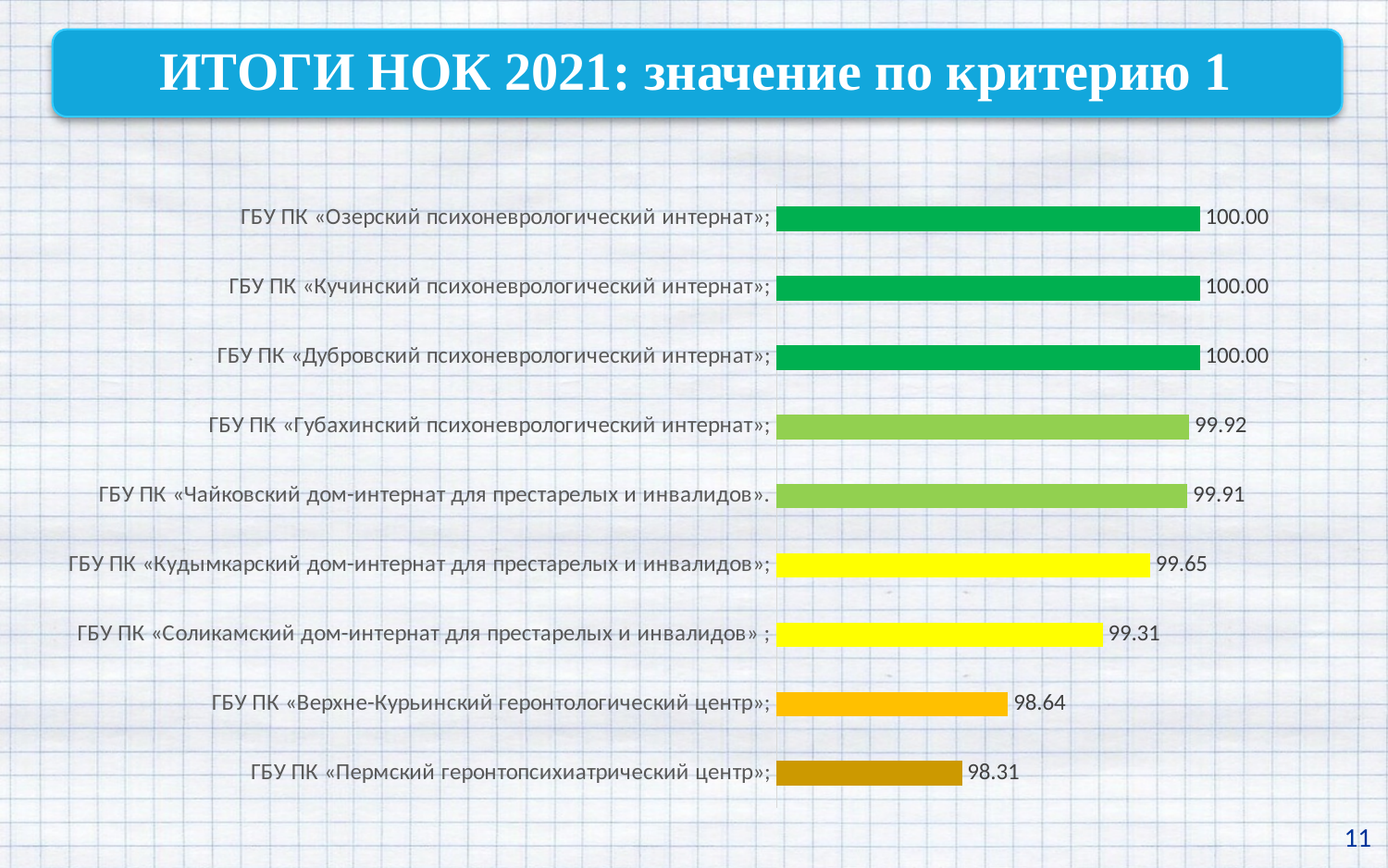
Which is larger: the value for ГБУ ПК «Чайковский дом-интернат для престарелых и инвалидов» or the value for ГБУ ПК «Соликамский дом-интернат для престарелых и инвалидов»? ГБУ ПК «Чайковский дом-интернат для престарелых и инвалидов» How many categories are shown on the chart? 9 What is the difference between the values for ГБУ ПК «Соликамский дом-интернат для престарелых и инвалидов» and ГБУ ПК «Пермский геронтопсихиатрический центр»? 1.00 What is the highest value shown on the chart? 100.00 What kind of chart is shown on the slide? Bar chart What is the title of the slide containing the chart? ИТОГИ НОК 2021: значение по критерию 1 What is the value for ГБУ ПК «Верхне-Курьинский геронтологический центр»? 98.64 What is the value for ГБУ ПК «Пермский геронтопсихиатрический центр»? 98.31 What is the difference between the values for ГБУ ПК «Озерский психоневрологический интернат» and ГБУ ПК «Верхне-Курьинский геронтологический центр»? 1.36 What is the value for ГБУ ПК «Кудымкарский дом-интернат для престарелых и инвалидов»? 99.65 Which category has the lowest value? ГБУ ПК «Пермский геронтопсихиатрический центр» What is the value for ГБУ ПК «Губахинский психоневрологический интернат»? 99.92